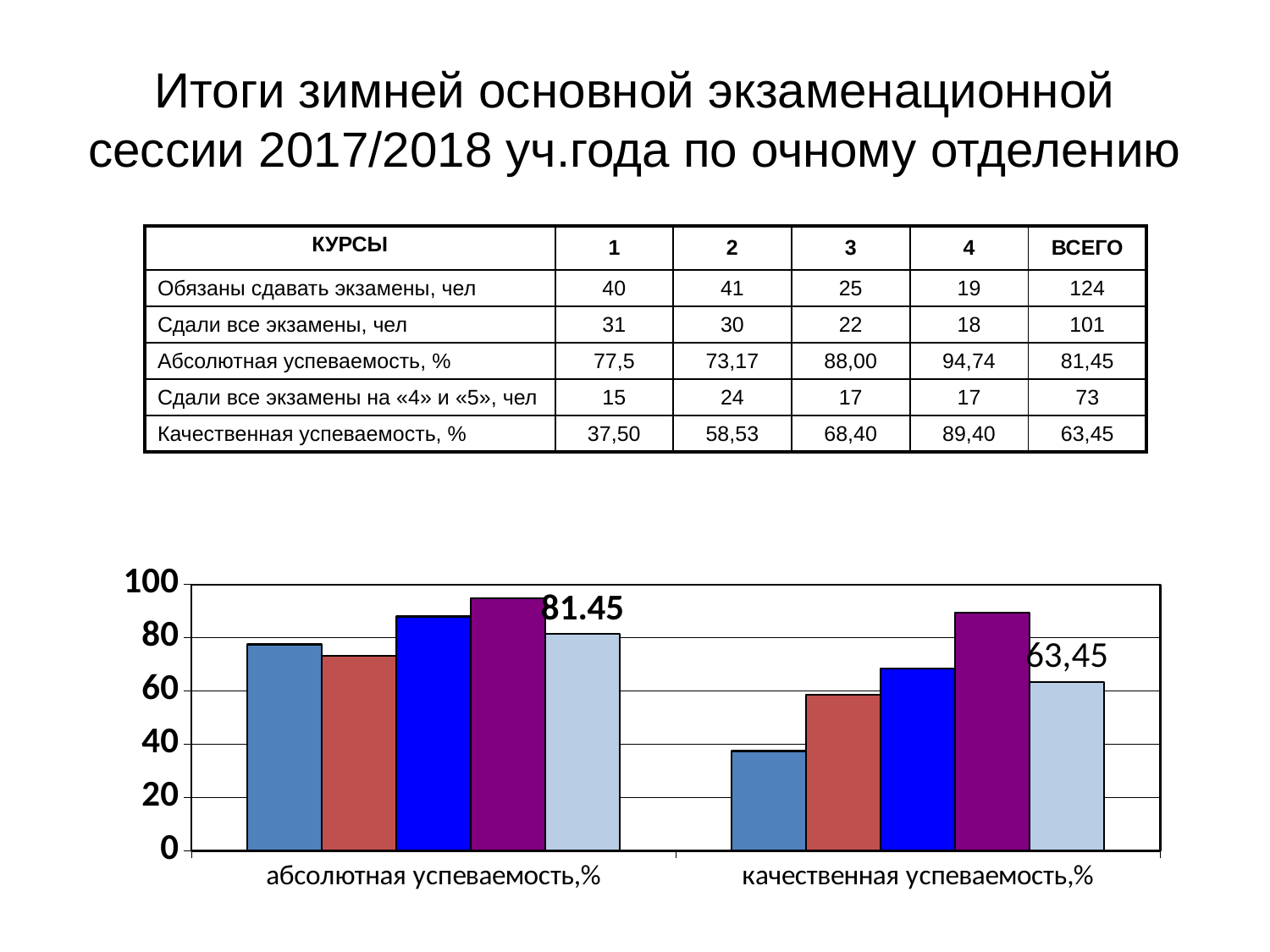
Is the value of the first (dark blue) bar in the 'абсолютная успеваемость,%' group greater or less than 60? greater What value is printed as the data label on the last (light blue) bar of the 'абсолютная успеваемость,%' group? 81.45 What is the highest value shown on the chart's vertical axis? 100 How many bars are plotted in each category group of the chart? 5 What is the difference between the two labelled values, 81.45 and 63,45? 18 Is the value of the purple bar in the 'качественная успеваемость,%' group greater or less than 80? greater Which labelled value is larger: the one in the 'абсолютная успеваемость,%' group or the one in the 'качественная успеваемость,%' group? абсолютная успеваемость,% (81.45) Is the value of the first (dark blue) bar in the 'качественная успеваемость,%' group greater or less than 60? less Which bar is the tallest in the 'абсолютная успеваемость,%' group? the purple (fourth) bar How many categories are shown on the x axis of the chart? 2 What value is printed as the data label on the last (light blue) bar of the 'качественная успеваемость,%' group? 63,45 What kind of chart is shown on the slide? bar chart